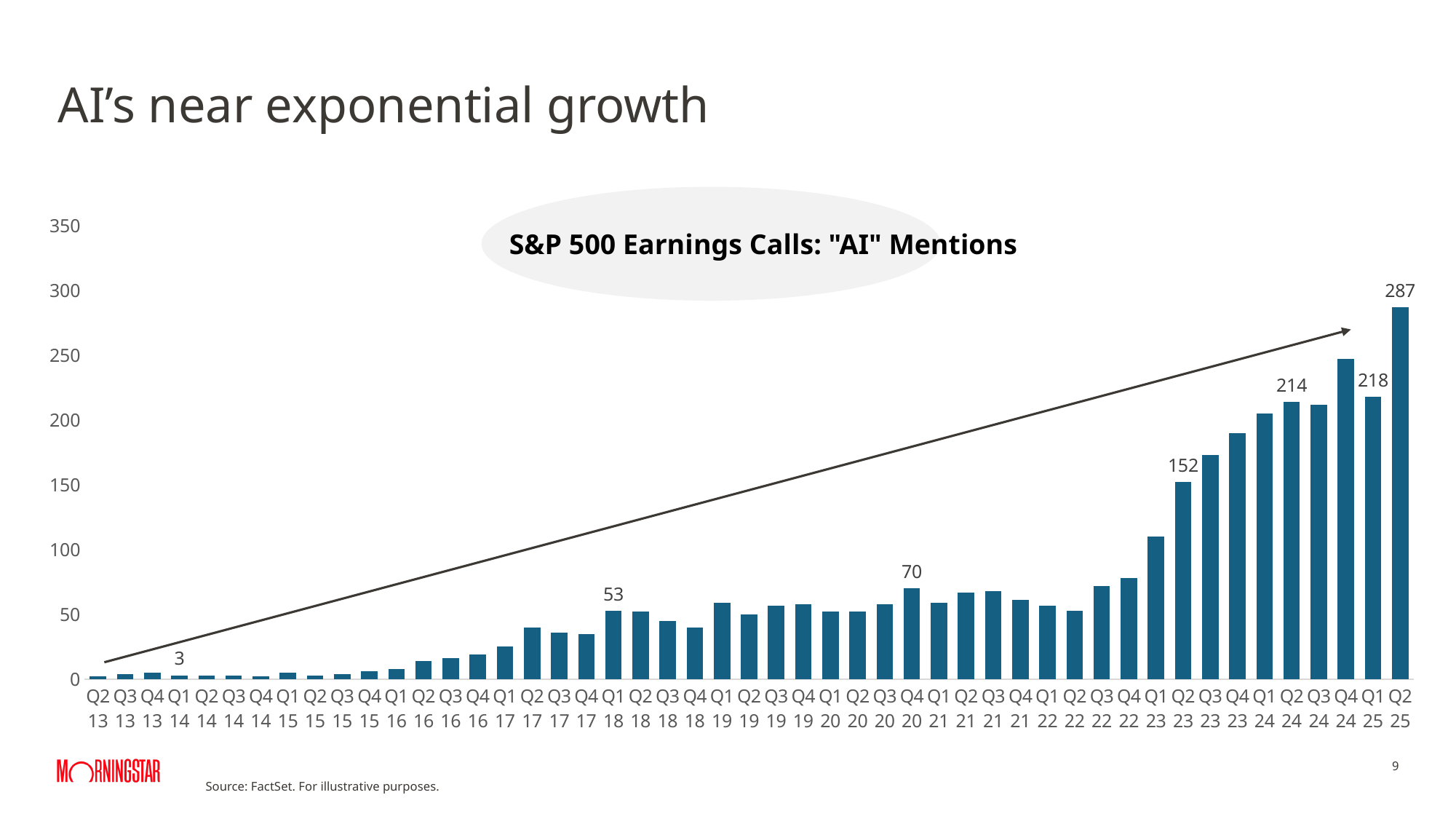
What kind of chart is shown on the slide? bar chart Which is larger, the value for Q1 18 or the value for Q4 20? Q4 20 Is the value for Q4 24 greater or less than 200? greater What is the difference between the values for Q2 25 and Q1 25? 69 How many "AI" mentions are shown for Q2 25? 287 What is the difference between the values for Q2 24 and Q2 23? 62 Which quarter has the highest number of "AI" mentions? Q2 25 Do the values generally rise or fall from Q2 13 to Q2 25? rise What is the title of the chart? S&P 500 Earnings Calls: "AI" Mentions What is the value labelled for Q2 23? 152 What is the value labelled for Q4 20? 70 Is the value for Q2 17 greater or less than 50? less